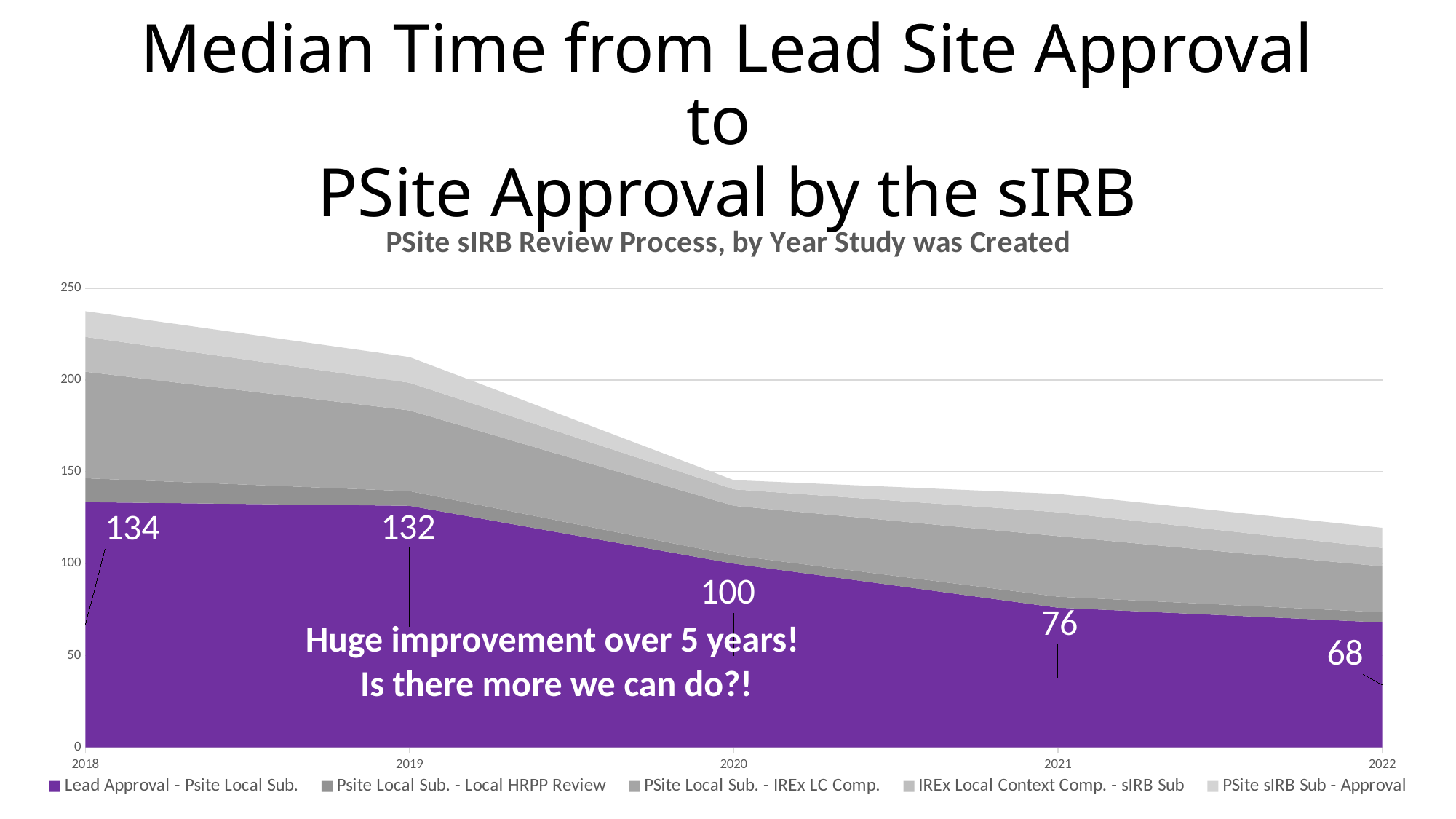
What kind of chart is shown? Stacked area chart How many series does the legend list? 5 What is the value for Lead Approval - Psite Local Sub. in 2018? 134 In which year is the Lead Approval - Psite Local Sub. value highest? 2018 What is the value for Lead Approval - Psite Local Sub. in 2022? 68 What is the value for Lead Approval - Psite Local Sub. in 2020? 100 Which year has the larger Lead Approval - Psite Local Sub. value, 2020 or 2021? 2020 What is the difference between the Lead Approval - Psite Local Sub. values for 2018 and 2022? 66 How many years are shown on the x axis? 5 Is the total stacked value for 2022 greater or less than 150? less Is the total stacked value for 2018 greater or less than 200? greater In which year is the Lead Approval - Psite Local Sub. value lowest? 2022